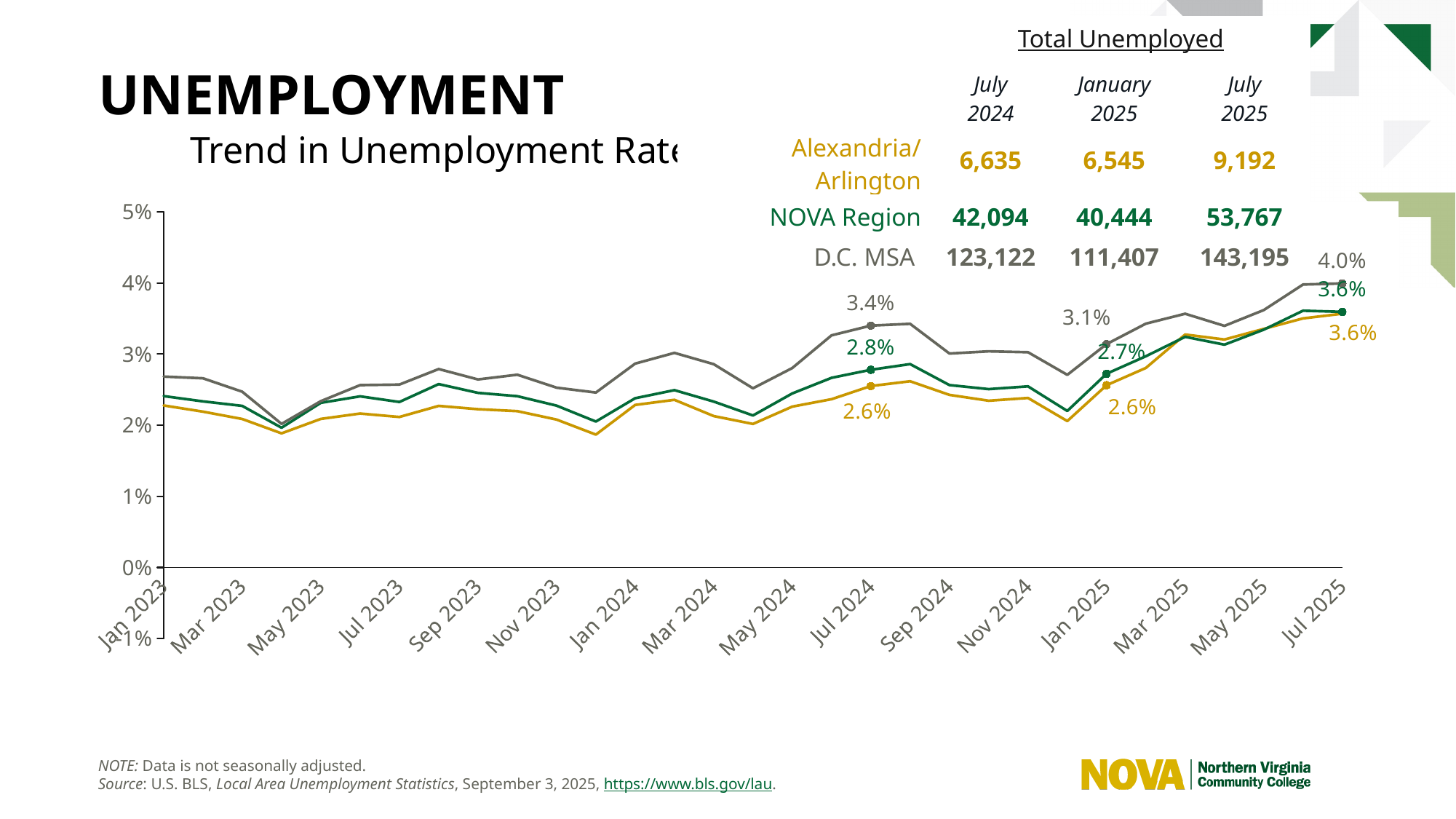
By how many percentage points did the D.C. MSA rate rise from Jul 2024 (3.4%) to Jul 2025 (4.0%)? 0.6 percentage points Which of the three series has the highest unemployment rate at Jul 2025? D.C. MSA How many series (lines) are plotted on the Trend in Unemployment Rate chart? 3 What kind of chart is used to show the trend in unemployment rate? line chart Is the D.C. MSA rate in Jan 2023 greater or less than 2%? greater What is the NOVA Region unemployment rate labelled for Jan 2025 on the chart? 2.7% At Jul 2024, which is higher: the NOVA Region rate or the Alexandria/Arlington rate? NOVA Region Does the D.C. MSA rate rise or fall between Jan 2025 and Jul 2025? rise By how many percentage points did the NOVA Region rate rise from Jan 2025 (2.7%) to Jul 2025 (3.6%)? 0.9 percentage points What is the D.C. MSA unemployment rate labelled for Jul 2024 on the Trend in Unemployment Rate chart? 3.4% What is the D.C. MSA unemployment rate labelled for Jul 2025 on the chart? 4.0% What is the Alexandria/Arlington unemployment rate labelled for Jul 2025 on the chart? 3.6%